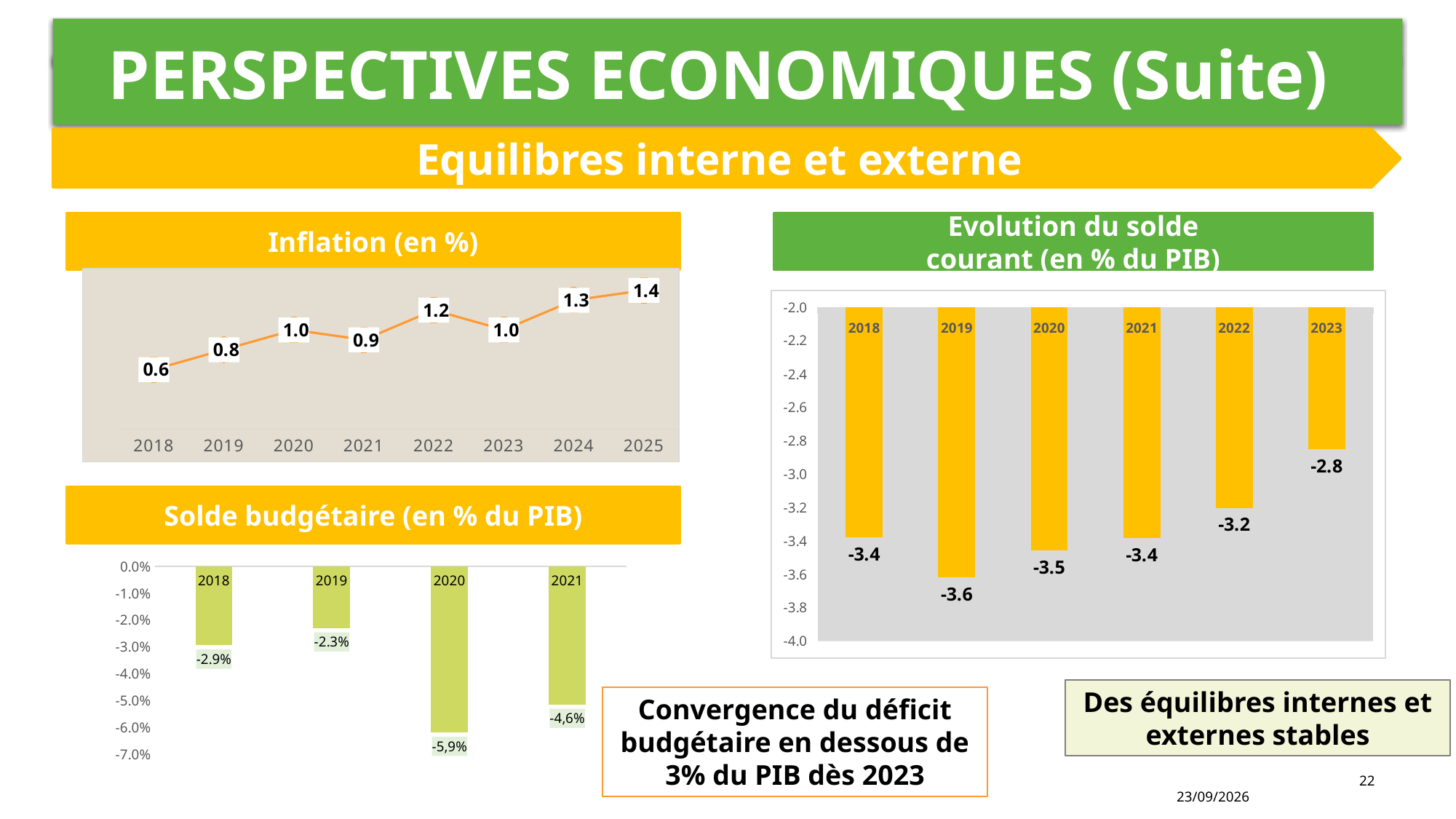
In the 'Evolution du solde courant (en % du PIB)' chart, what is the value for 2019? -3.6 What kind of chart is the 'Inflation (en %)' chart? Line chart In the 'Inflation (en %)' chart, what is the difference between the values for 2025 and 2018? 0.8 In the 'Solde budgétaire (en % du PIB)' chart, how many years are shown? 4 In the 'Inflation (en %)' chart, how many years are plotted? 8 What kind of chart is the 'Evolution du solde courant (en % du PIB)' chart? Bar chart In the 'Evolution du solde courant (en % du PIB)' chart, which is larger, the value for 2022 or the value for 2020? 2022 In the 'Solde budgétaire (en % du PIB)' chart, what is the value for 2020? -5,9% In the 'Inflation (en %)' chart, which year has the highest value? 2025 In the 'Evolution du solde courant (en % du PIB)' chart, which year has the highest (least negative) value? 2023 In the 'Inflation (en %)' chart, what is the value for 2018? 0.6 In the 'Solde budgétaire (en % du PIB)' chart, which year has the lowest (most negative) value? 2020